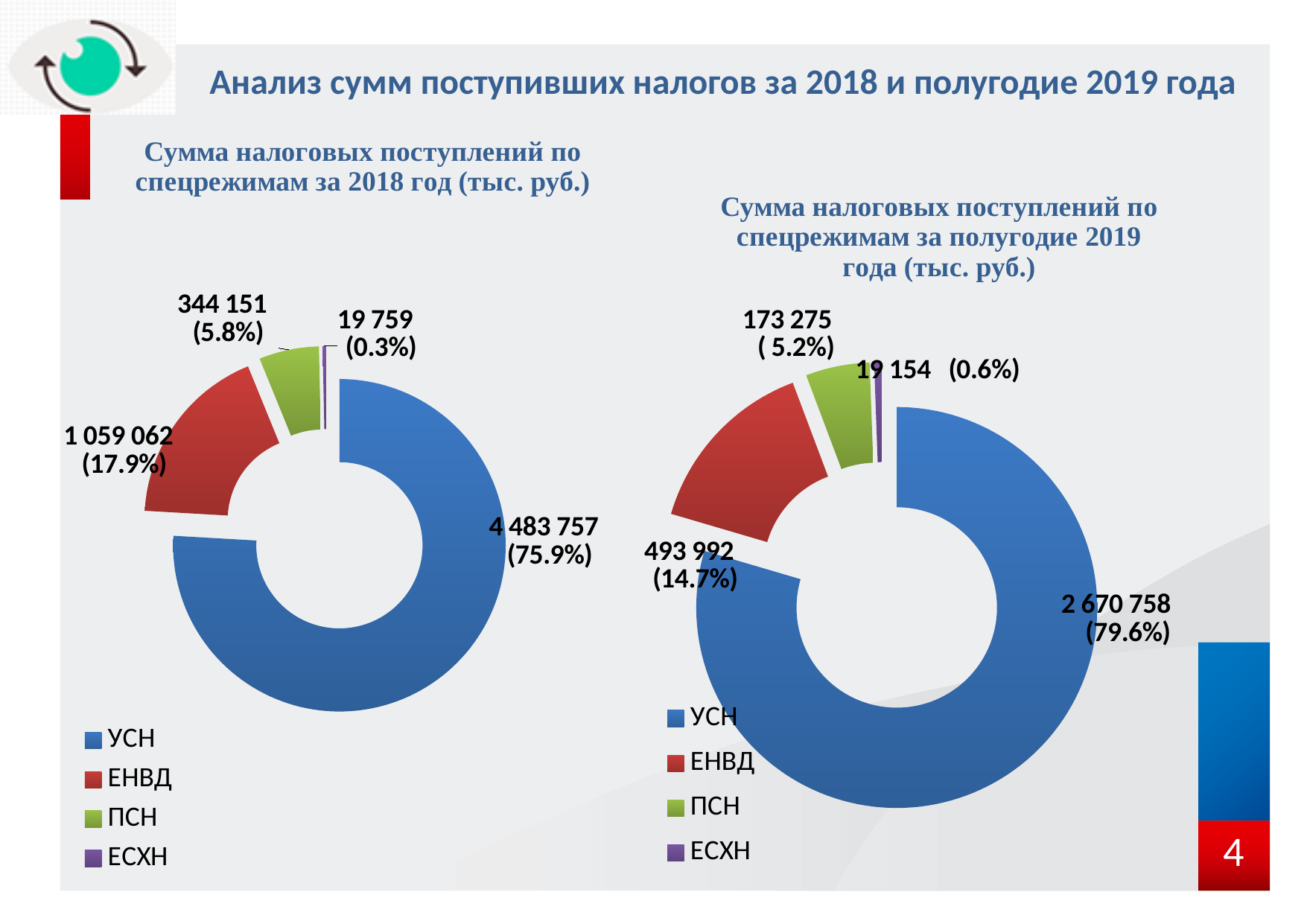
In the left chart (2018), what is the value for ПСН? 344 151 In the right chart (half-year 2019), what is the value for ЕНВД? 493 992 How many categories does the right chart (half-year 2019) show? 4 In the right chart (half-year 2019), what share of the total does УСН account for? 79.6% In the left chart (2018), what is the value for УСН? 4 483 757 In the left chart (2018), which category has the largest value? УСН In the left chart (2018), what share of the total does ЕНВД account for? 17.9% In the right chart (half-year 2019), which category has the smallest value? ЕСХН What kind of chart is the left chart (2018)? Doughnut (pie) chart In the right chart (half-year 2019), what is the value for ЕСХН? 19 154 In the left chart (2018), what is the difference between the values for ЕНВД and ПСН? 714 911 Which is larger: the value for ПСН in the left chart (2018) or the value for ПСН in the right chart (half-year 2019)? Left chart (2018)